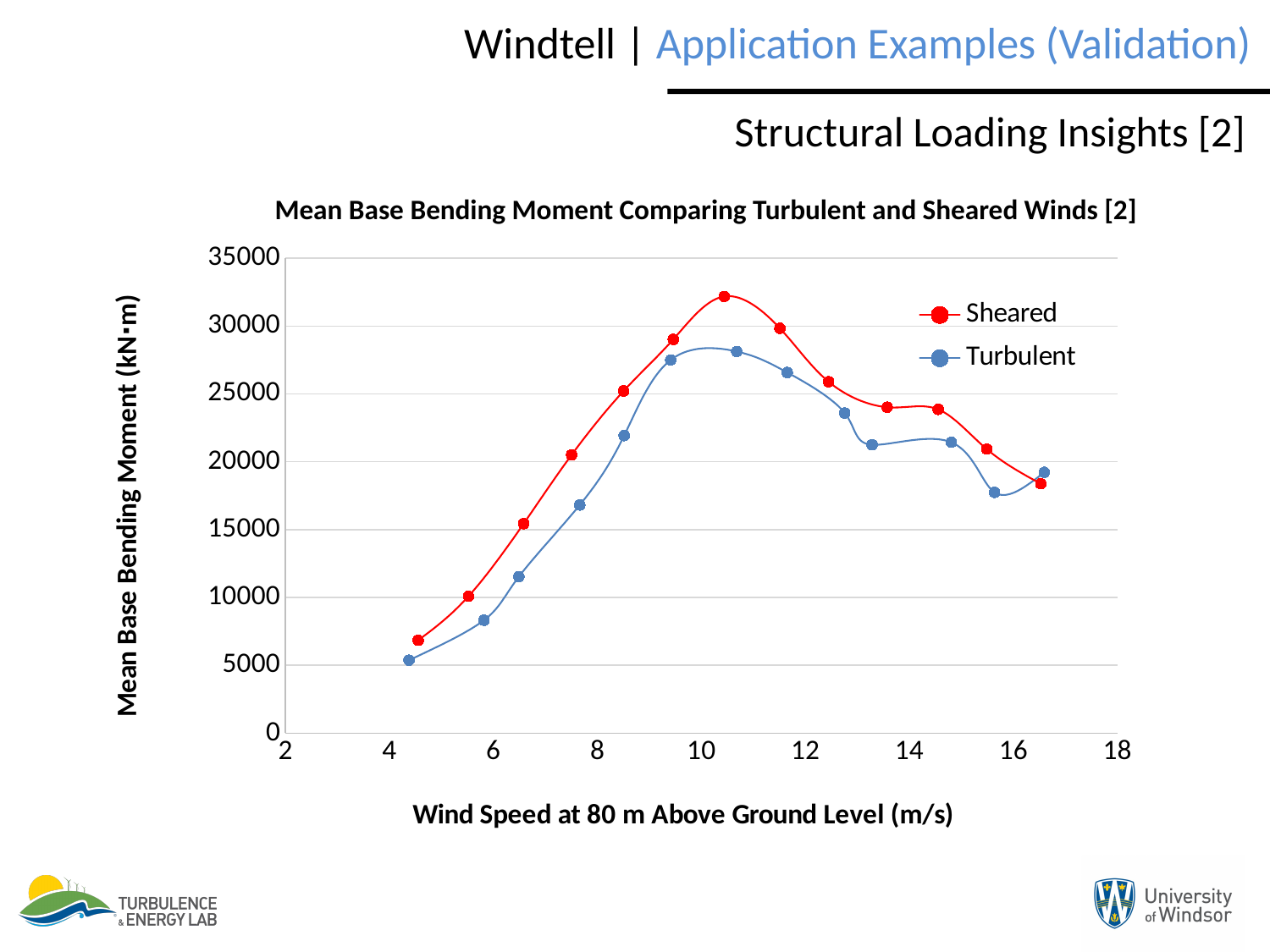
Which series reaches the higher peak mean base bending moment? Sheared Is the last Sheared point (at about 16.5 m/s) greater or less than 20000? less Is the peak value of the Turbulent series greater or less than 30000? less What is the title of the chart? Mean Base Bending Moment Comparing Turbulent and Sheared Winds [2] At a wind speed of about 10.5 m/s, which series has the larger mean base bending moment, Sheared or Turbulent? Sheared Is the first Sheared point (at about 4.5 m/s) greater or less than 5000? greater What are the two series named in the legend? Sheared and Turbulent How many data points are plotted for the Sheared series? 13 What kind of chart is shown on the slide? Line chart How do the Sheared values change as wind speed increases from 4 m/s to 10 m/s? They rise How many series does the legend list? 2